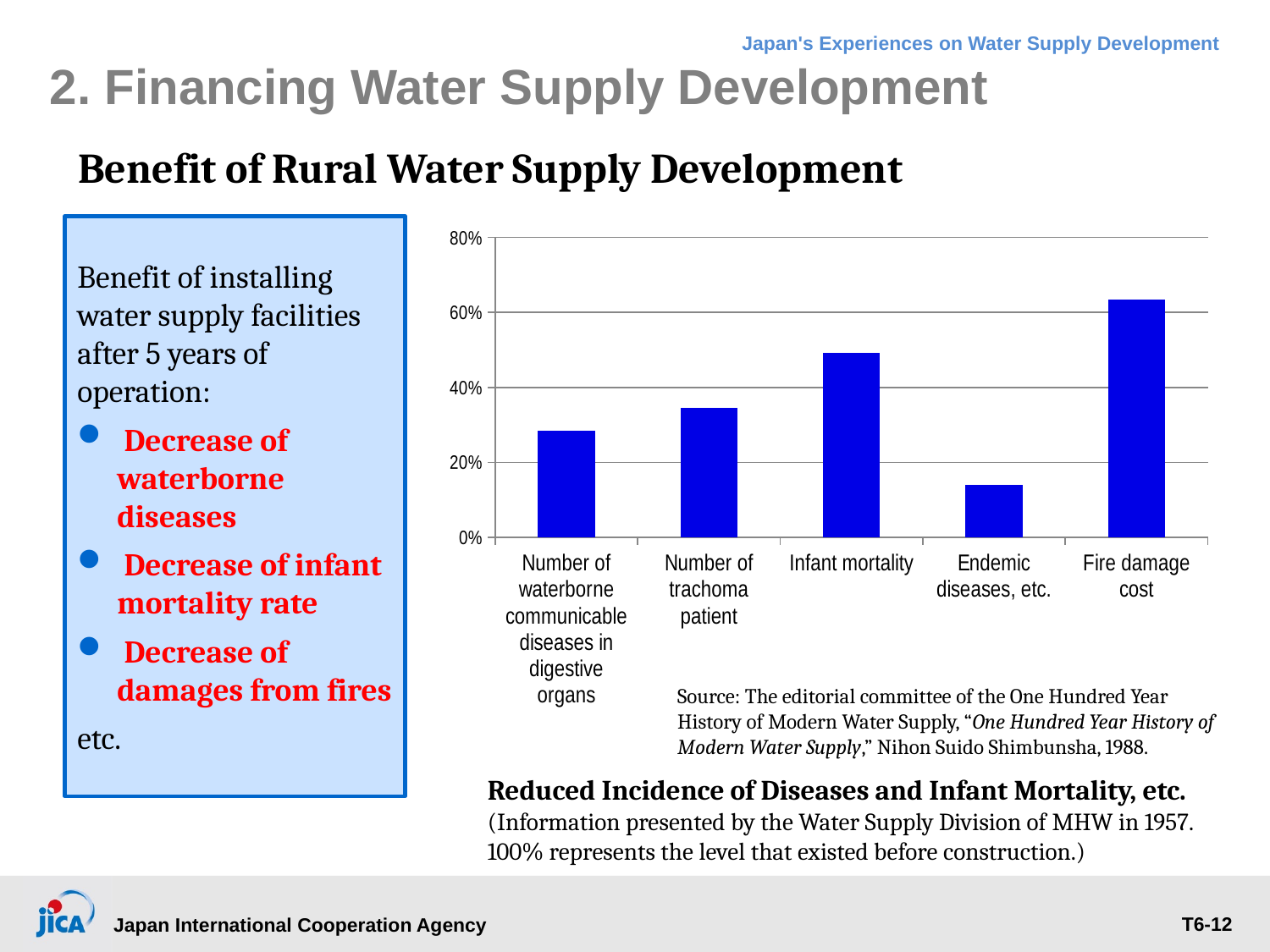
Is the value for Fire damage cost greater or less than 40%? greater Which is larger, the value for Number of waterborne communicable diseases in digestive organs or the value for Endemic diseases, etc.? Number of waterborne communicable diseases in digestive organs Which category has the highest value in the chart? Fire damage cost Is the value for Endemic diseases, etc. greater or less than 20%? less How many categories are plotted in the chart? 5 What colour are the bars in the chart? blue What kind of chart is shown on the slide? bar chart Is the value for Infant mortality greater or less than 40%? greater Which category has the lowest value in the chart? Endemic diseases, etc. Which is larger, the value for Infant mortality or the value for Number of trachoma patient? Infant mortality